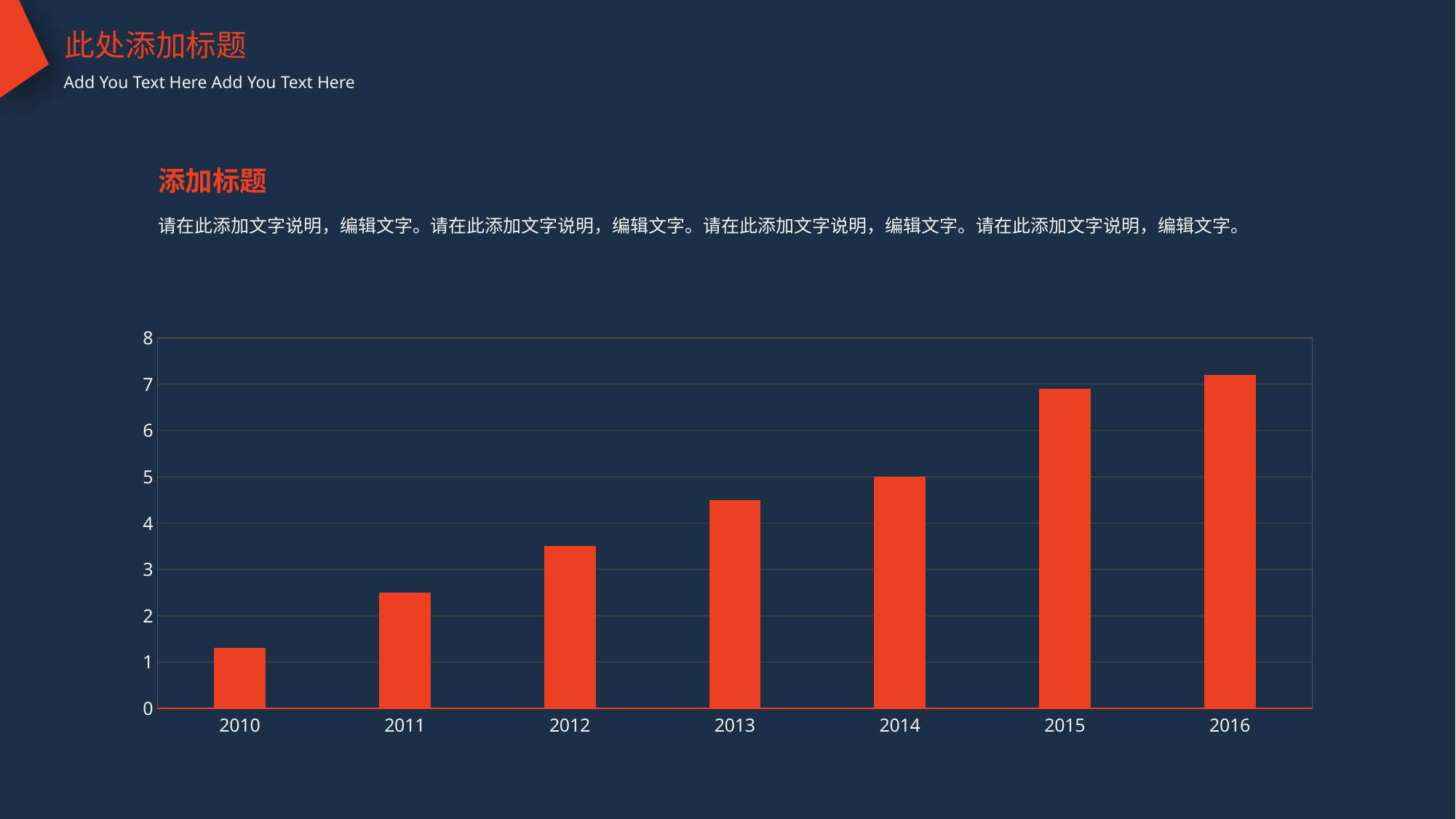
How many years are shown on the x axis of the chart? 7 Is the value for 2013 greater or less than 5? less What kind of chart is shown on the slide? bar chart What colour are the bars in the chart? red-orange Which year has the lowest bar in the chart? 2010 Is the value for 2015 greater or less than 6? greater Do the values rise or fall from 2010 to 2016? rise Which year has the highest bar in the chart? 2016 Is the value for 2012 greater or less than 3? greater Which is larger, the value for 2011 or the value for 2013? 2013 What is the value for 2014? 5